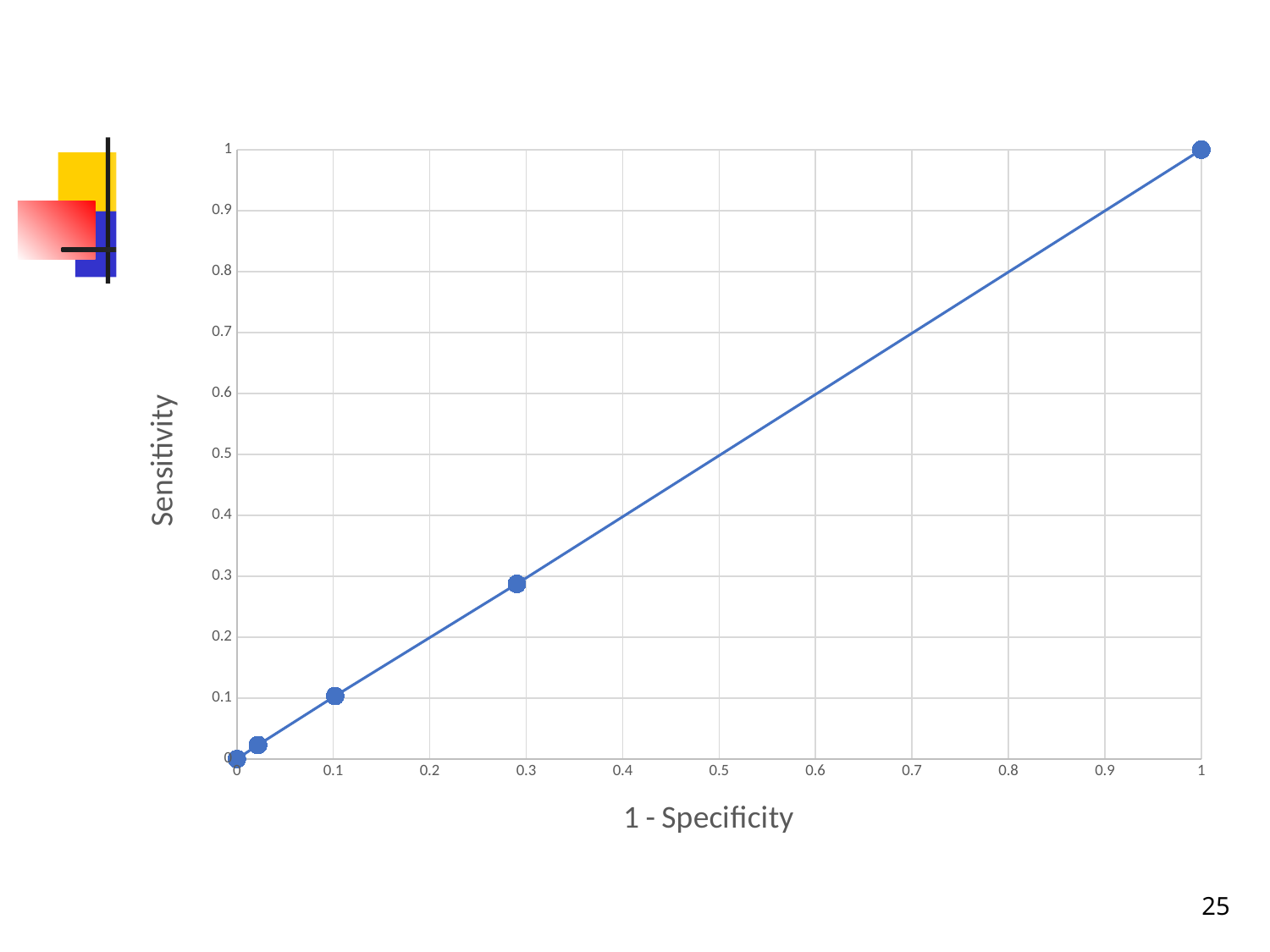
How many data points are plotted on the chart? 5 What is the label of the vertical axis? Sensitivity Is the Sensitivity of the point plotted near 1 - Specificity = 0.3 greater or less than 0.2? greater Is the Sensitivity of the point plotted near 1 - Specificity = 0.1 greater or less than 0.2? less Do the plotted values rise or fall as 1 - Specificity increases along the x axis? rise What is the Sensitivity value of the point plotted at 1 - Specificity = 0? 0 What is the Sensitivity value of the point plotted at 1 - Specificity = 1? 1 What kind of chart is shown on the slide? line chart What is the label of the horizontal axis? 1 - Specificity Which plotted point has the highest Sensitivity? the point at 1 - Specificity = 1 Which has the higher Sensitivity: the point near 1 - Specificity = 0.1 or the point near 1 - Specificity = 0.3? the point near 0.3 Is the Sensitivity of the point plotted near 1 - Specificity = 0.3 greater or less than 0.4? less